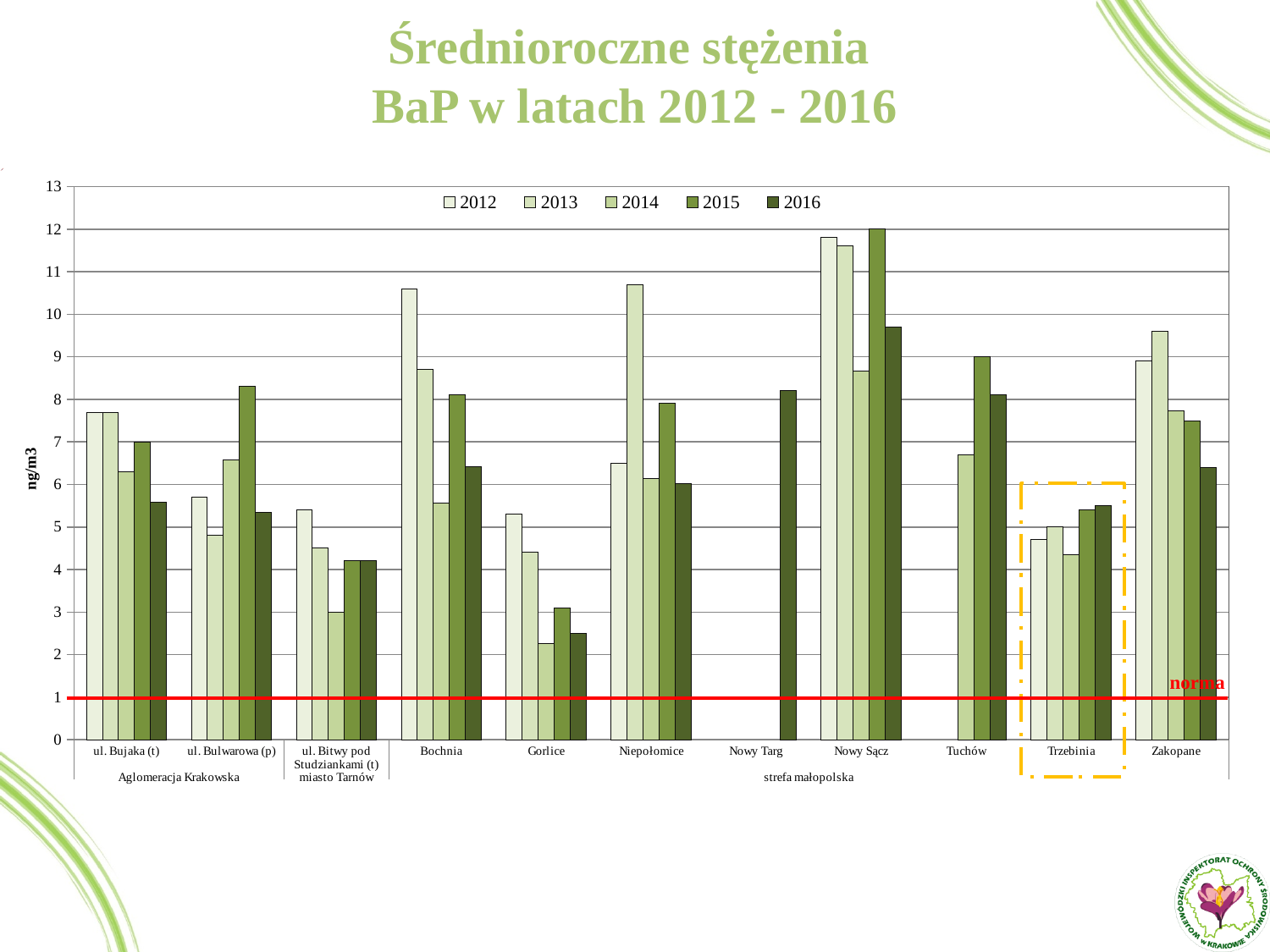
Which station has the highest 2012 value? Nowy Sącz Which station has the lowest 2014 value? Gorlice Is the 2014 value for Gorlice greater or less than 3? less What label is written next to the red horizontal line on the chart? norma How many series does the legend list? 5 Is the 2012 value for Bochnia greater or less than 10? greater Is the 2014 value for Trzebinia greater or less than 5? less For Gorlice, do the values rise or fall from 2012 to 2014? fall What kind of chart is shown on the slide? bar chart How many measurement stations (categories) are shown on the x axis? 11 For Bochnia, which is larger: the 2012 value or the 2013 value? 2012